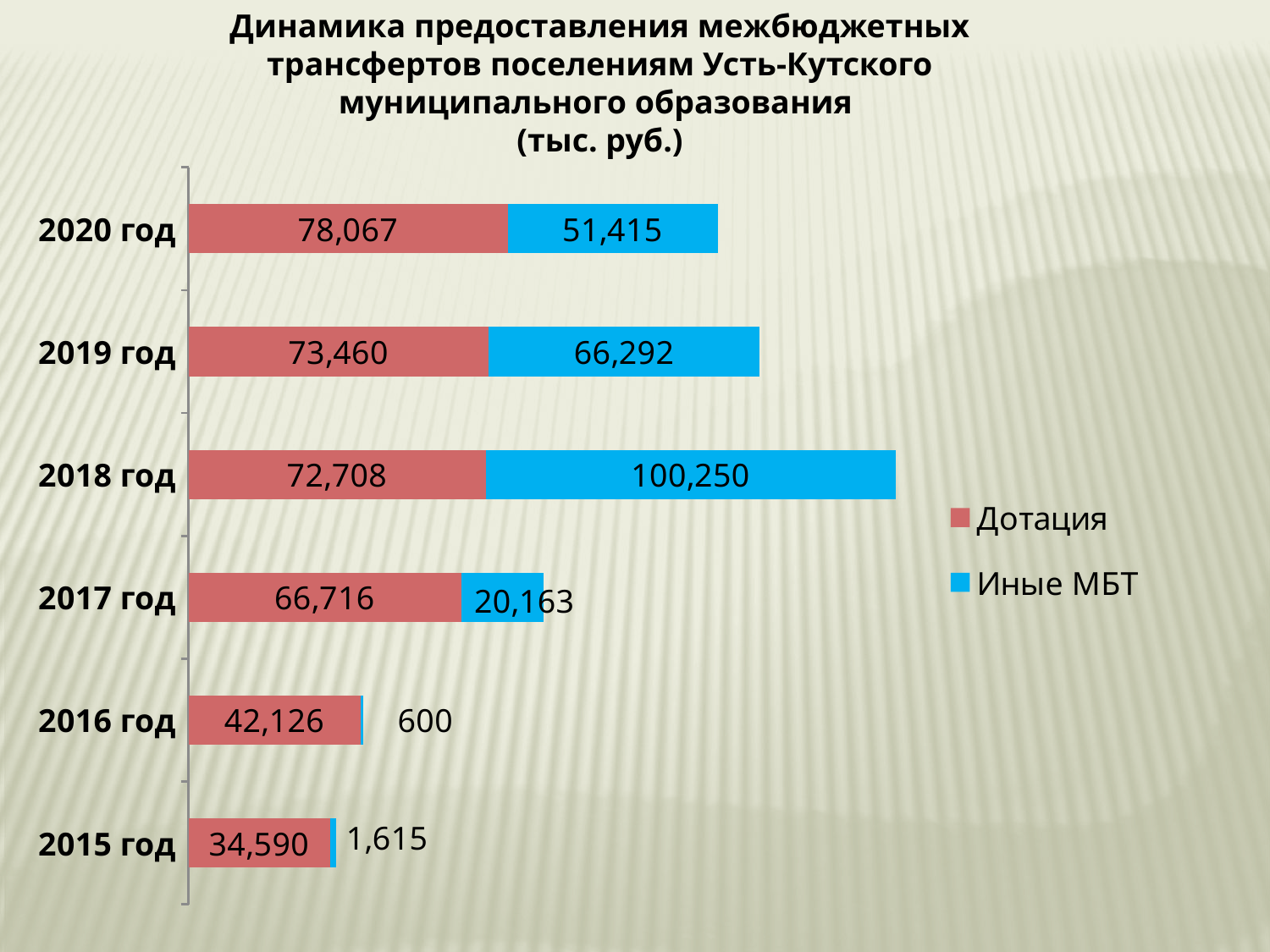
What is the Иные МБТ value for 2018 год? 100,250 Which year has the highest Дотация value? 2020 год Which year has the lowest Иные МБТ value? 2016 год Which is larger: the Иные МБТ value for 2019 год or for 2020 год? 2019 год What is the Иные МБТ value for 2016 год? 600 Which year has the highest Иные МБТ value? 2018 год What is the difference between the Дотация values for 2020 год and 2019 год? 4,607 How many years are shown on the chart? 6 What is the total of the stacked bar for 2018 год? 172,958 What is the Дотация value for 2020 год? 78,067 How many series does the legend list? 2 What is the total of the stacked bar for 2015 год? 36,205